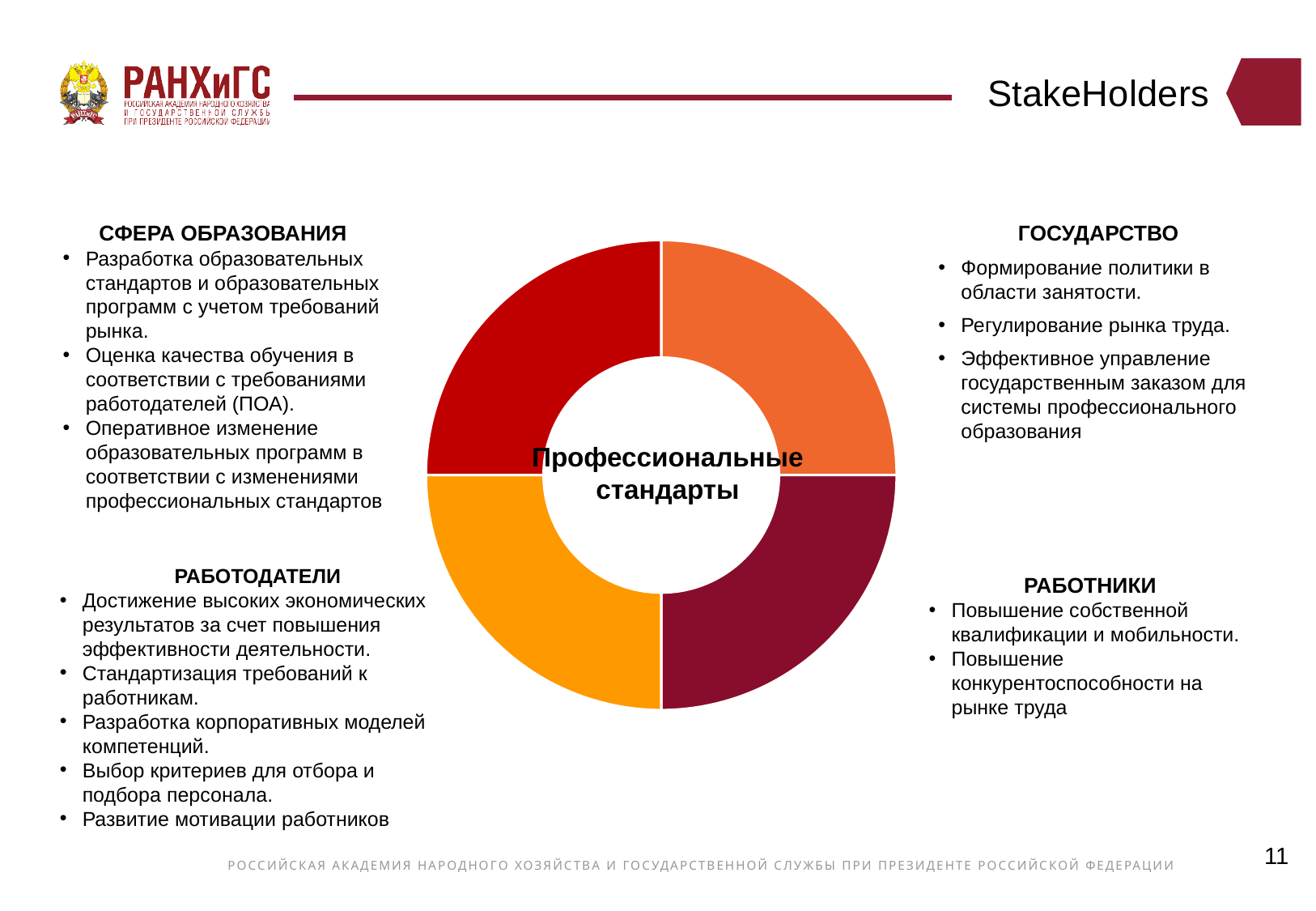
How many segments does the doughnut chart have? 4 What kind of chart is shown in the centre of the slide? Doughnut (ring) chart What colour is the top-right segment of the doughnut chart? Orange Do the segments of the doughnut chart appear equal in size or different? Equal What text is written in the centre of the doughnut chart? Профессиональные стандарты